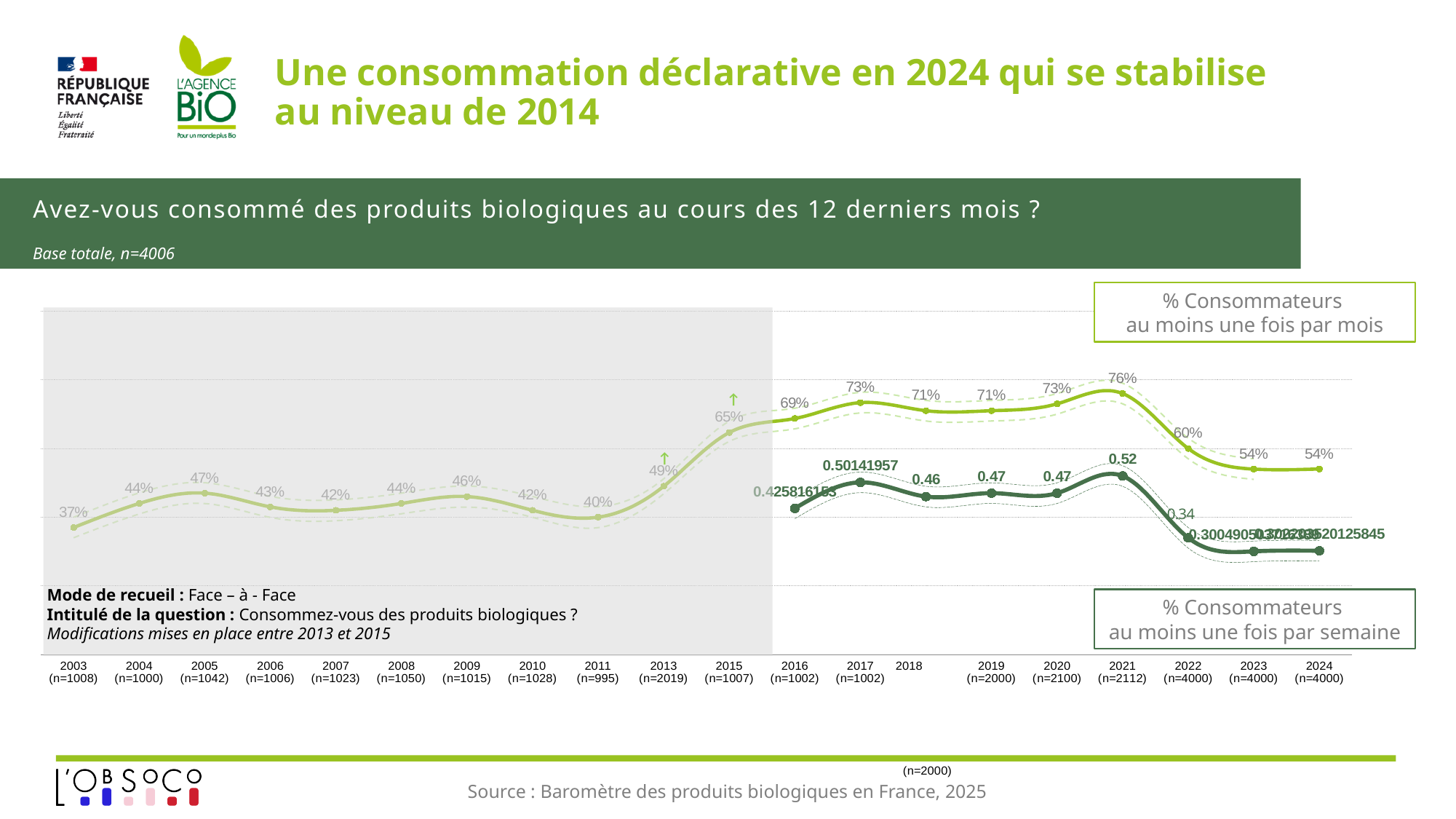
Does the '% Consommateurs au moins une fois par mois' series rise or fall between 2021 and 2023? fall How many series does the chart show? 2 In which year is the '% Consommateurs au moins une fois par mois' series highest? 2021 What is the value for 2022 in the '% Consommateurs au moins une fois par semaine' series? 0.34 What is the value for 2021 in the '% Consommateurs au moins une fois par semaine' series? 0.52 What type of chart is shown on the slide? line chart In which year is the '% Consommateurs au moins une fois par mois' series lowest? 2003 Which year has the higher value in the '% Consommateurs au moins une fois par mois' series, 2017 or 2018? 2017 What is the value for 2024 in the '% Consommateurs au moins une fois par mois' series? 54% What is the value for 2003 in the '% Consommateurs au moins une fois par mois' series? 37% What is the difference between the 2021 and 2024 values of the '% Consommateurs au moins une fois par mois' series? 22 percentage points What is the value for 2021 in the '% Consommateurs au moins une fois par mois' series? 76%